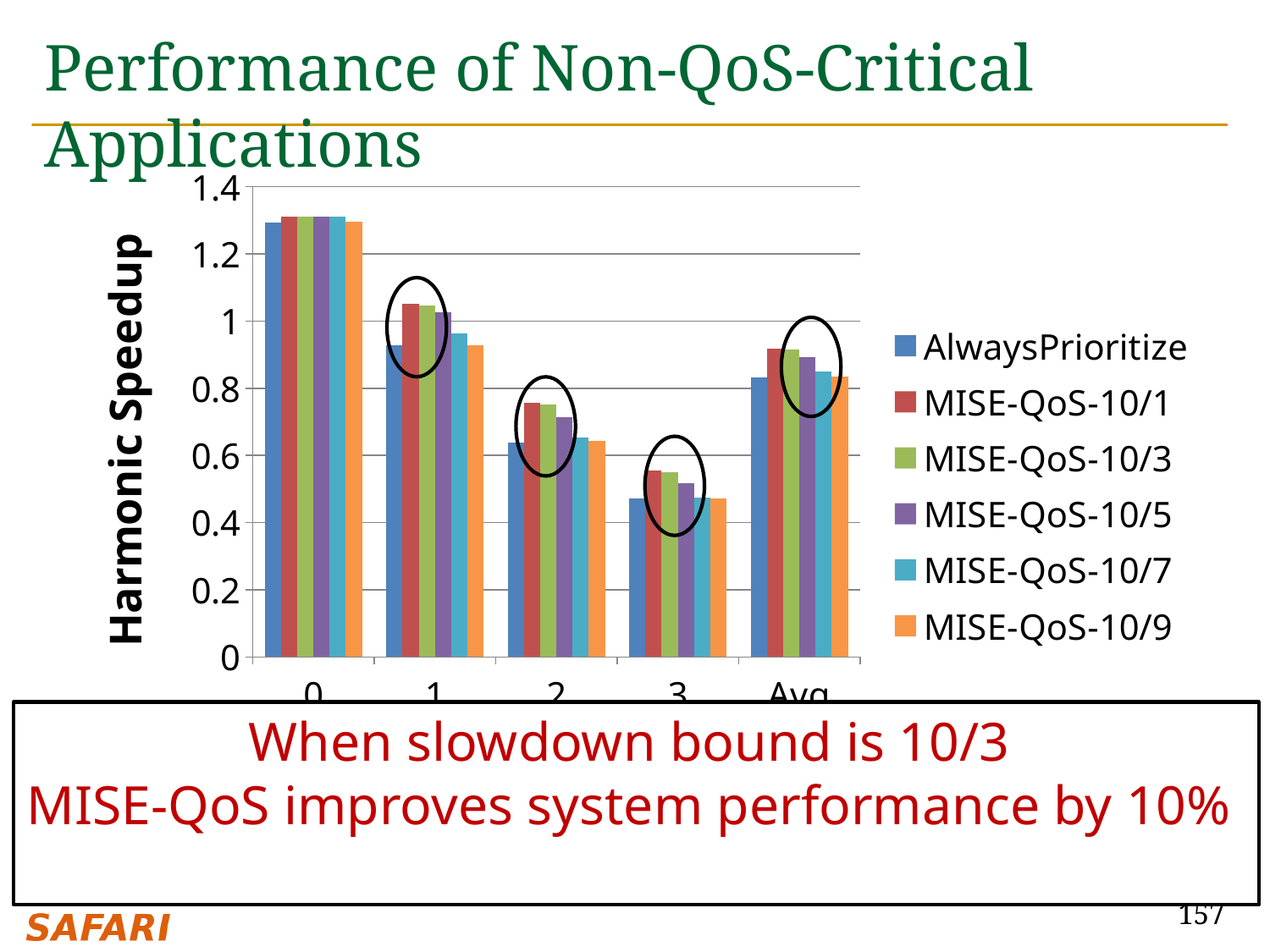
What is the label of the y axis? Harmonic Speedup Which category has the lowest harmonic speedup values across all series? 3 For category 2, which is larger: AlwaysPrioritize or MISE-QoS-10/3? MISE-QoS-10/3 What kind of chart is shown on the slide? bar chart How many categories are shown along the x axis? 5 How many series does the legend list? 6 Is the value for MISE-QoS-10/1 in category 2 greater or less than 1? less For category 1, which is larger: AlwaysPrioritize or MISE-QoS-10/1? MISE-QoS-10/1 Which series is shown in orange in the legend? MISE-QoS-10/9 Is the value for AlwaysPrioritize in category 1 greater or less than 0.8? greater Which category has the highest harmonic speedup values across all series? 0 Do the harmonic speedup values rise or fall from category 0 to category 3? fall